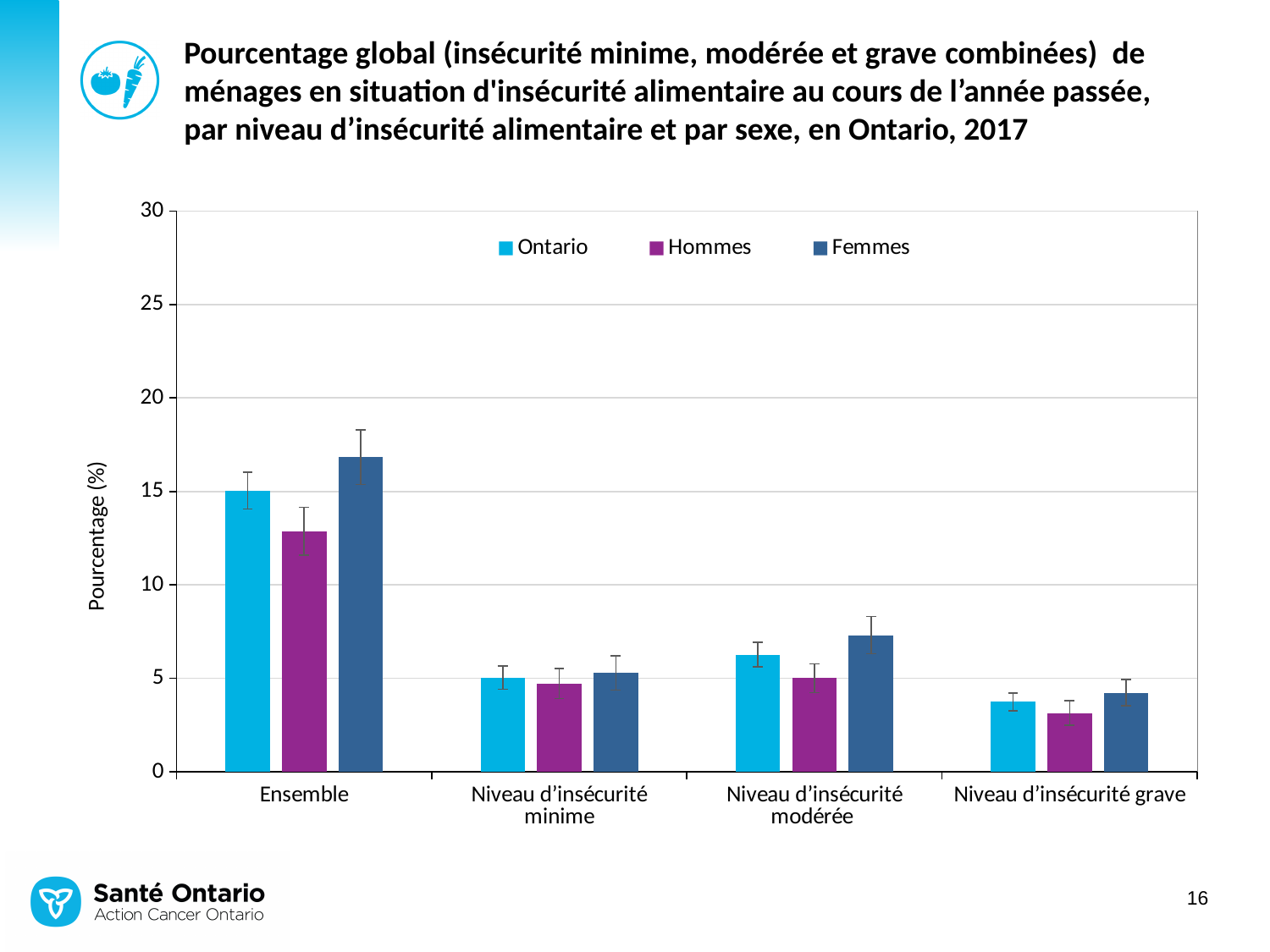
Is the value for Femmes in the Ensemble category greater or less than 15? greater Which category has the lowest value for the Hommes series? Niveau d’insécurité grave What kind of chart is shown on the slide? bar chart What is the label of the y axis? Pourcentage (%) Which category has the highest value for the Femmes series? Ensemble How many categories are shown on the x axis? 4 How many series does the legend list? 3 In the Niveau d’insécurité modérée category, which is larger: the value for Ontario or the value for Hommes? Ontario Is the value for Hommes in the Ensemble category greater or less than 15? less In the Ensemble category, which is larger: the value for Hommes or the value for Femmes? Femmes Is the value for Femmes in the Niveau d’insécurité modérée category greater or less than 5? greater